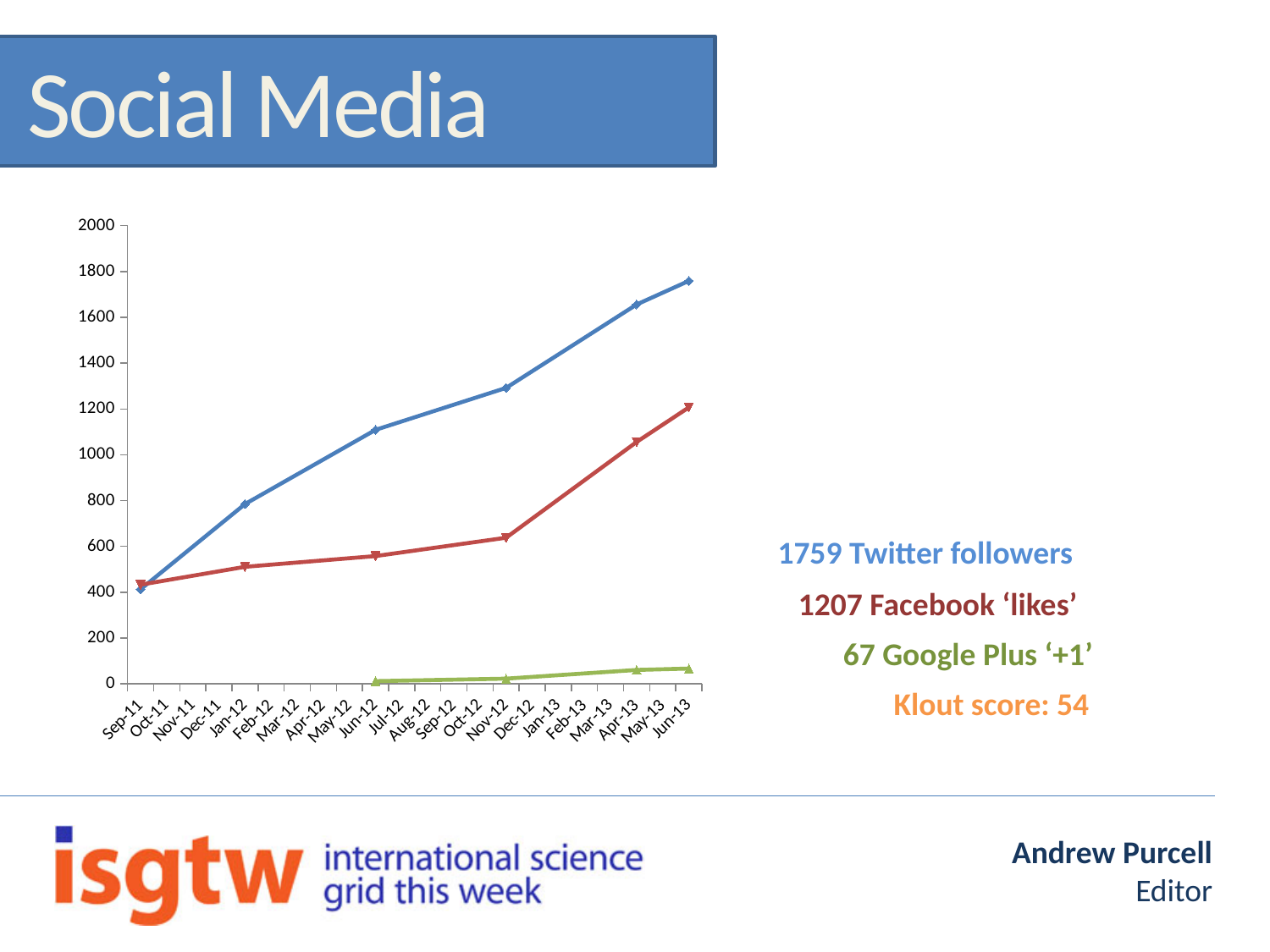
Is the value of the blue line at Jun-12 greater or less than 1000? greater What is the value of the red line (Facebook 'likes') at Jun-13? 1207 What kind of chart is shown on the slide? line chart Does the blue line rise or fall from Sep-11 to Jun-13? rise What is the difference between Twitter followers and Facebook 'likes' at Jun-13? 552 What is the value of the blue line (Twitter followers) at Jun-13? 1759 Which line has the lowest values throughout the chart? Google Plus '+1' (green) Is the value of the red line at Nov-12 greater or less than 800? less How many lines are plotted on the chart? 3 Which line reaches the highest value at Jun-13? Twitter followers (blue) What is the value of the green line (Google Plus '+1') at Jun-13? 67 How many month labels are shown along the x axis of the chart? 22